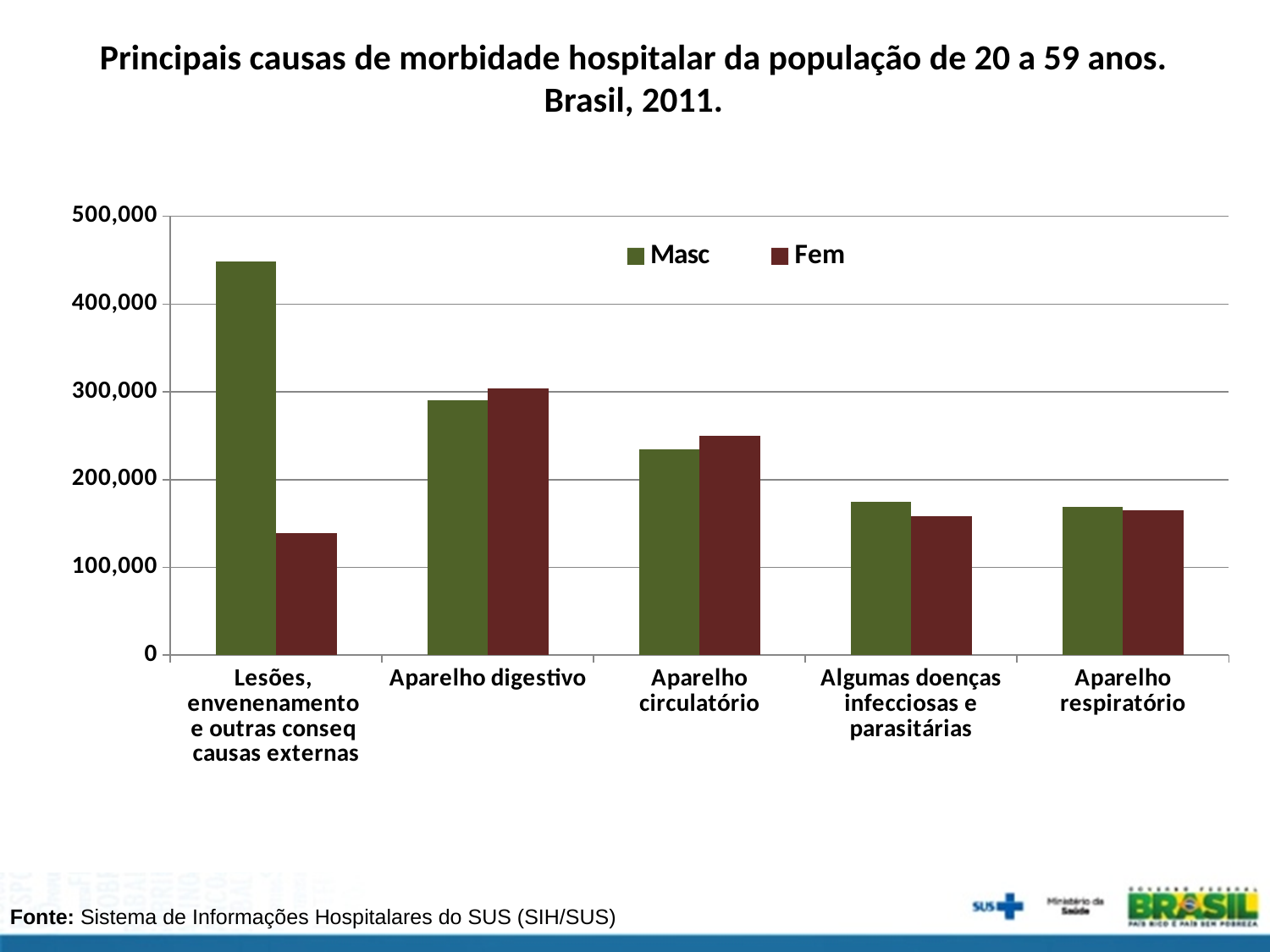
What kind of chart is shown on the slide? bar chart How many series does the legend list? 2 For Aparelho digestivo, which is larger, the Masc value or the Fem value? Fem For Lesões, envenenamento e outras conseq causas externas, which is larger, the Masc value or the Fem value? Masc How many categories (causes) are shown on the x axis? 5 Is the Masc value for Lesões, envenenamento e outras conseq causas externas greater or less than 400,000? greater What are the two series named in the legend? Masc and Fem Which category has the highest value for the Masc series? Lesões, envenenamento e outras conseq causas externas Which category has the highest value for the Fem series? Aparelho digestivo Is the Fem value for Lesões, envenenamento e outras conseq causas externas greater or less than 200,000? less Is the Fem value for Aparelho circulatório greater or less than 200,000? greater Which category has the lowest value for the Fem series? Lesões, envenenamento e outras conseq causas externas